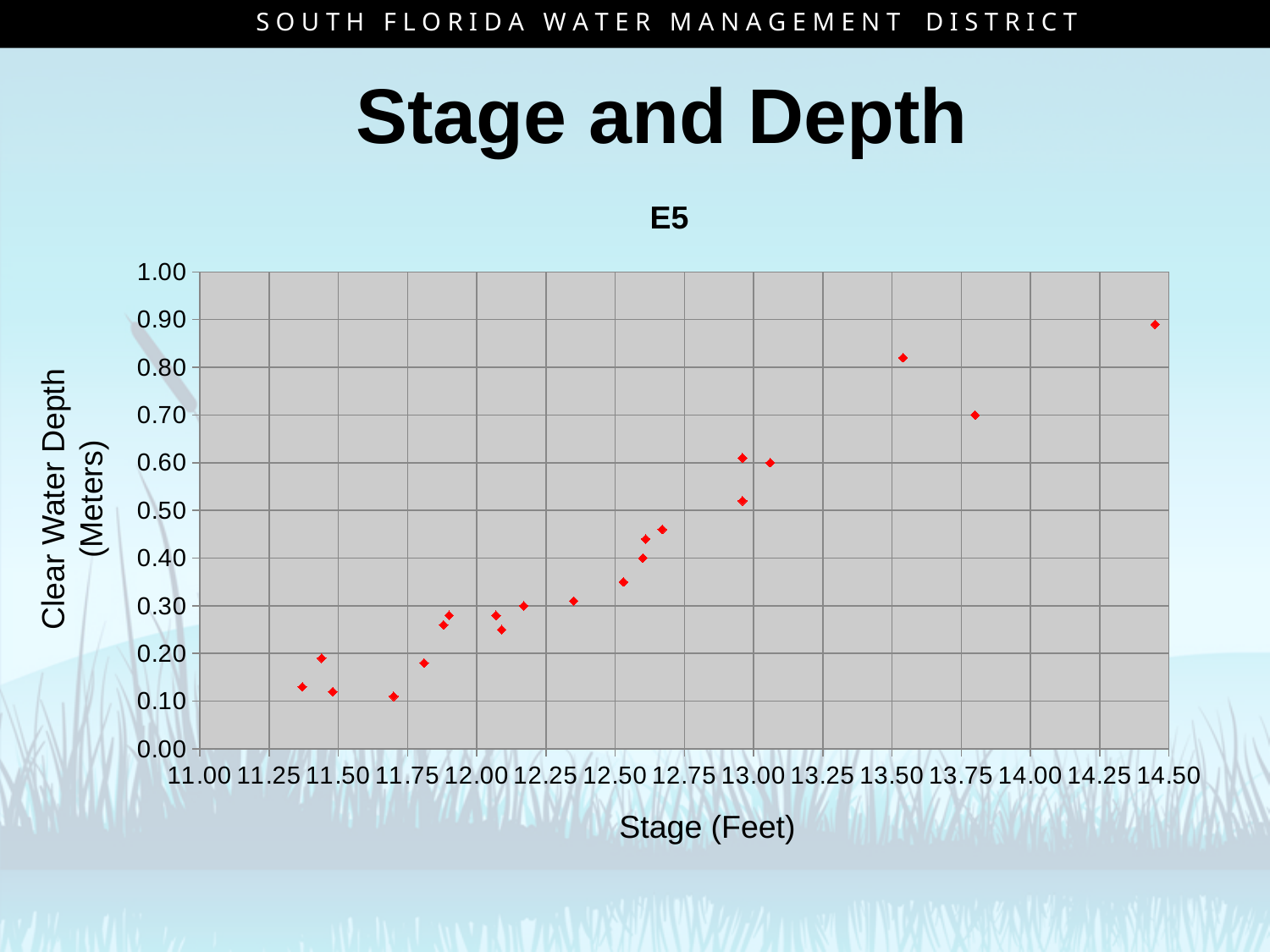
Do the clear water depth values generally rise or fall as stage increases along the x axis? Rise What kind of chart is shown on the slide? Scatter chart Is the clear water depth for the point near stage 12.50 feet greater or less than 0.30? greater Is the clear water depth for the point near stage 12.50 feet greater or less than 0.40? less What is the highest value shown on the y axis? 1.00 Is the clear water depth for the point near stage 11.40 feet greater or less than 0.20? less Which point has the highest clear water depth: the one near stage 13.50 feet or the one near stage 14.50 feet? The one near stage 14.50 feet What is the label of the x axis? Stage (Feet) What is the title of the chart? E5 Which point has the greater clear water depth: the one near stage 13.50 feet or the one near stage 13.80 feet? The one near stage 13.50 feet